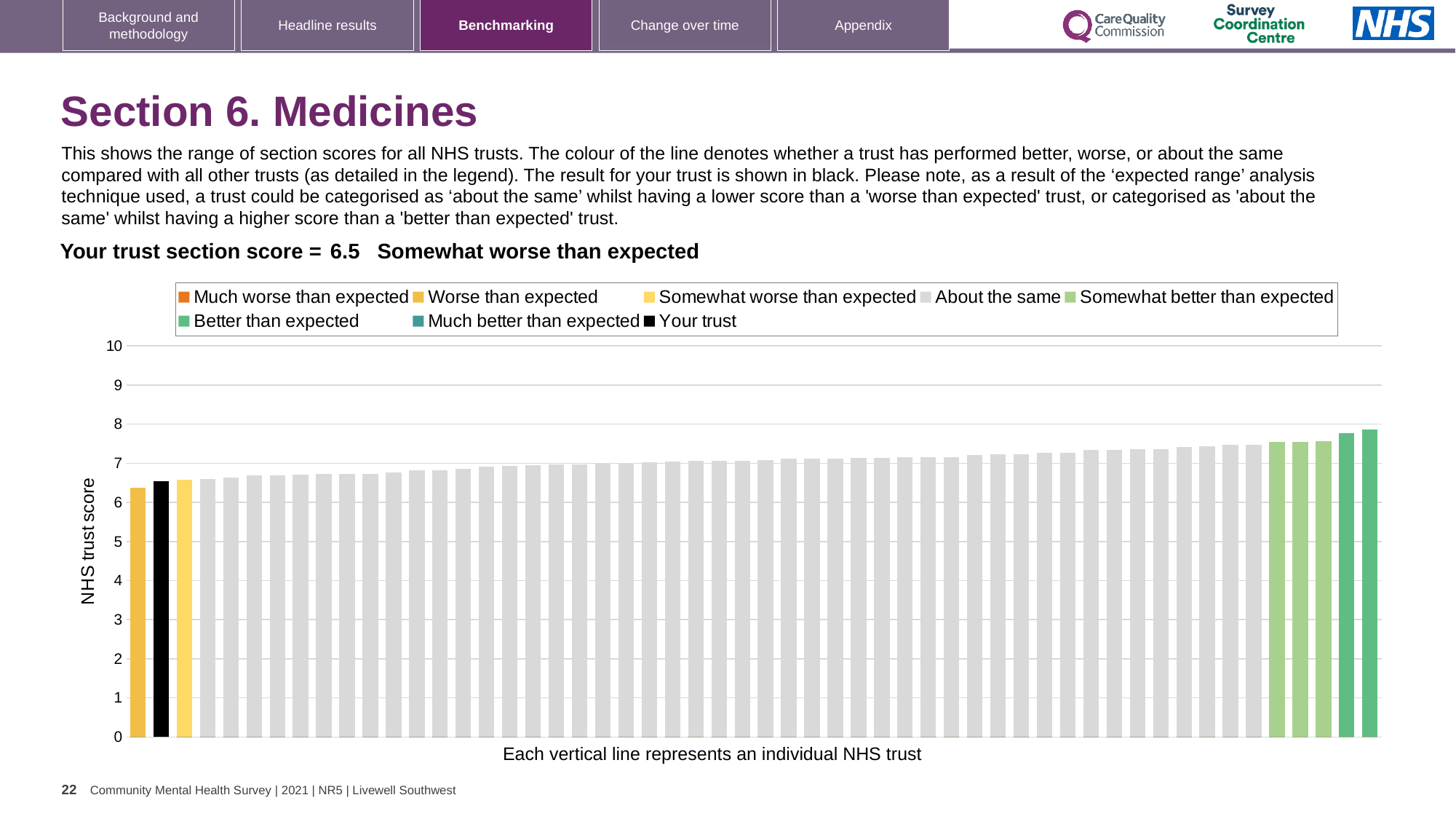
What is the section score for your trust shown on the slide? 6.5 Is the value for your trust's bar greater or less than 6? greater How many entries does the chart legend list? 8 Do the bar values rise or fall from left to right across the chart? rise What colour is the bar representing your trust? black Is the value of the tallest bar greater or less than 7? greater What kind of chart is shown on the slide? bar chart Which performance category is your trust placed in for Section 6. Medicines? Somewhat worse than expected Is the value of the shortest bar greater or less than 7? less What is the label on the vertical axis of the chart? NHS trust score